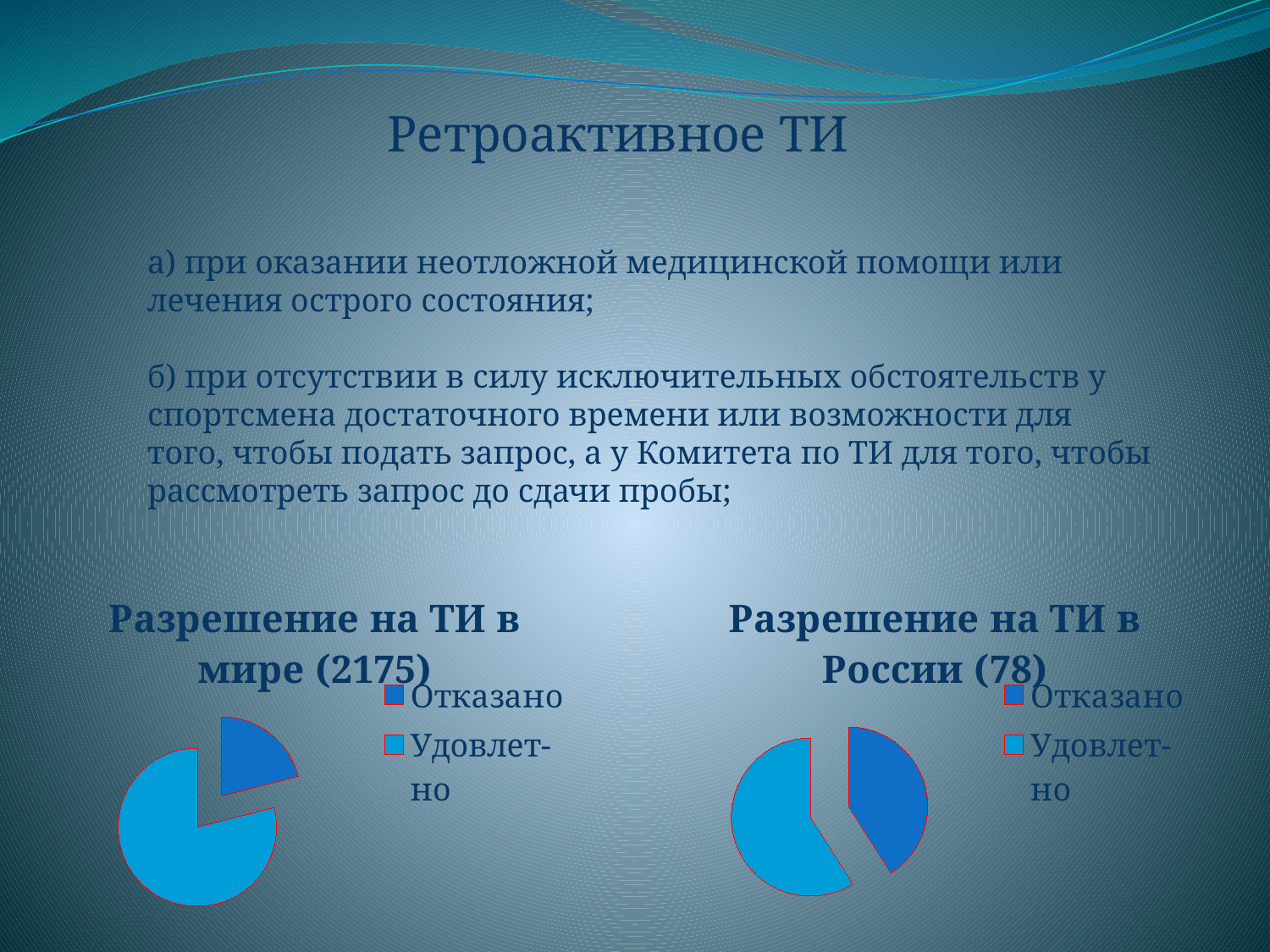
In the chart "Разрешение на ТИ в мире (2175)", how many slices does the pie have? 2 What is the title of the pie chart on the left of the slide? Разрешение на ТИ в мире (2175) In the chart "Разрешение на ТИ в России (78)", which slice is the smallest? Отказано What kind of chart is "Разрешение на ТИ в мире (2175)"? pie chart In the chart "Разрешение на ТИ в мире (2175)", which slice is the smallest? Отказано In the chart "Разрешение на ТИ в России (78)", which is larger: Отказано or Удовлетворено? Удовлет-но In the chart "Разрешение на ТИ в России (78)", how many entries does the legend list? 2 In the chart "Разрешение на ТИ в мире (2175)", which is larger: Отказано or Удовлетворено? Удовлет-но In the chart "Разрешение на ТИ в мире (2175)", which slice is the largest? Удовлет-но What number appears in parentheses in the title of the pie chart on the right of the slide? 78 What kind of chart is "Разрешение на ТИ в России (78)"? pie chart In the chart "Разрешение на ТИ в России (78)", which slice is the largest? Удовлет-но